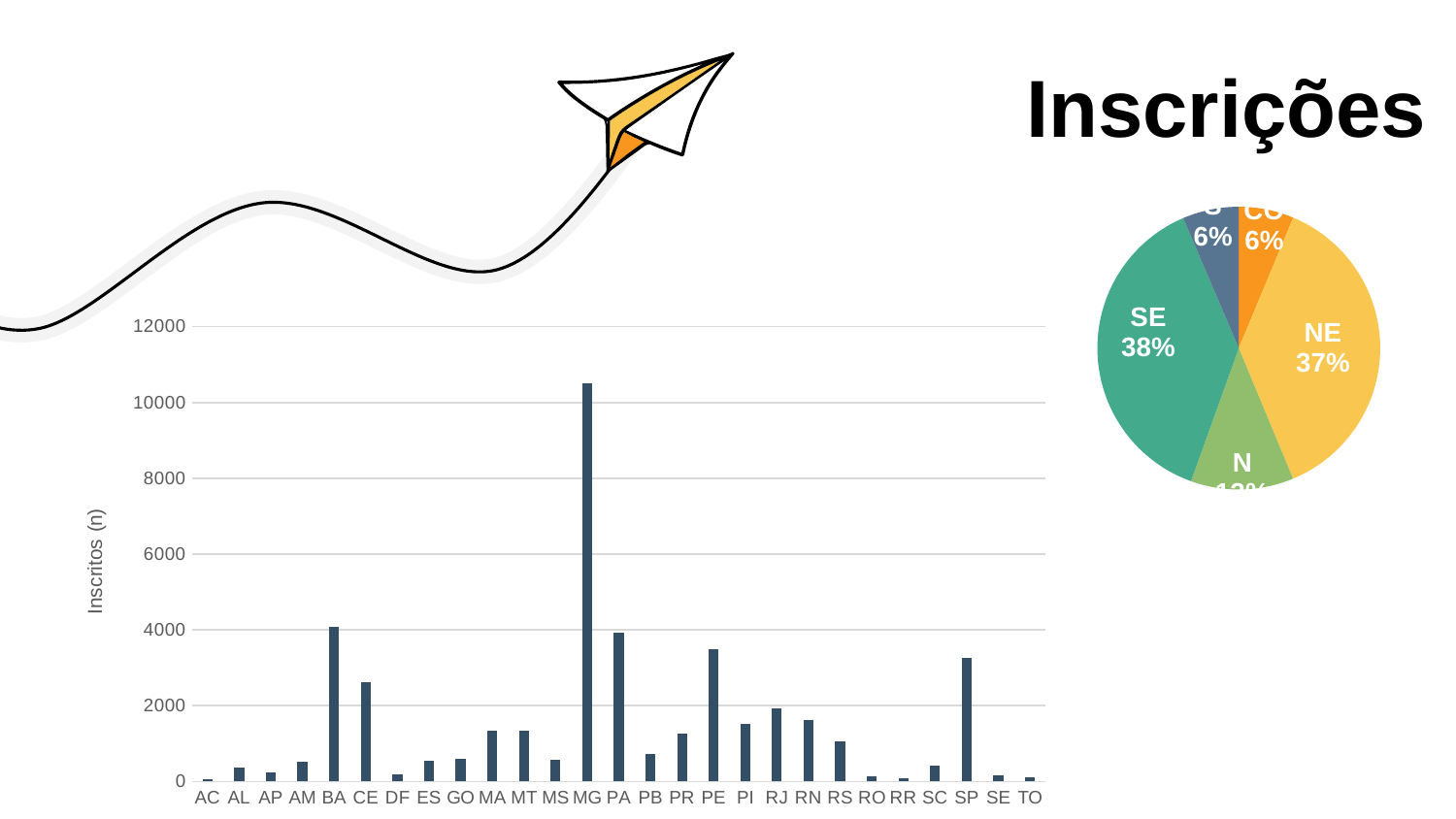
In the pie chart on the right, what share does SE have? 38% In the pie chart on the right, what is the difference between the SE and NE shares? 1% In the bar chart on the left, which state has the larger value, RJ or RN? RJ In the bar chart on the left, which state has the larger value, BA or CE? BA What kind of chart is the chart on the left of the slide? bar chart In the bar chart on the left, how many states are shown on the x axis? 27 In the pie chart on the right, what share does NE have? 37% In the bar chart on the left, is the value for SP greater or less than 4000? less What kind of chart is the chart on the right of the slide, under the title 'Inscrições'? pie chart In the bar chart on the left, which state has the highest number of Inscritos (n)? MG In the bar chart on the left, is the value for CE greater or less than 2000? greater In the bar chart on the left, is the value for MG greater or less than 10000? greater